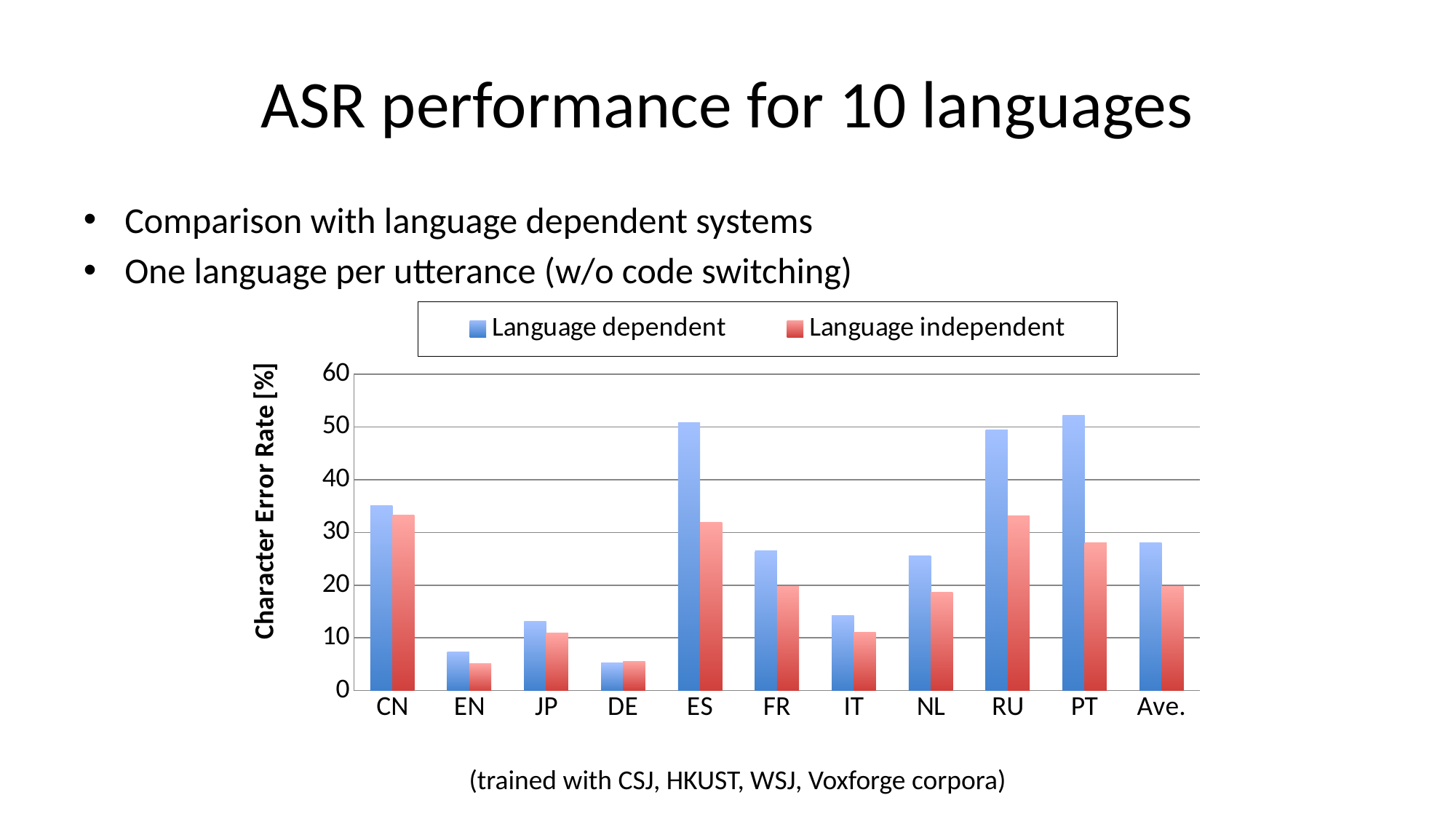
Is the Language dependent value for CN greater or less than 30? greater What is the label of the y axis? Character Error Rate [%] Is the Language dependent value for Ave. greater or less than 30? less For ES, which is larger: the Language dependent or the Language independent value? Language dependent What kind of chart is shown on the slide? bar chart How many series does the legend list? 2 Is the Language independent value for PT greater or less than 20? greater How many categories are shown along the x axis? 11 Which category has the lowest Language dependent value? DE Which colour represents the Language independent series? red